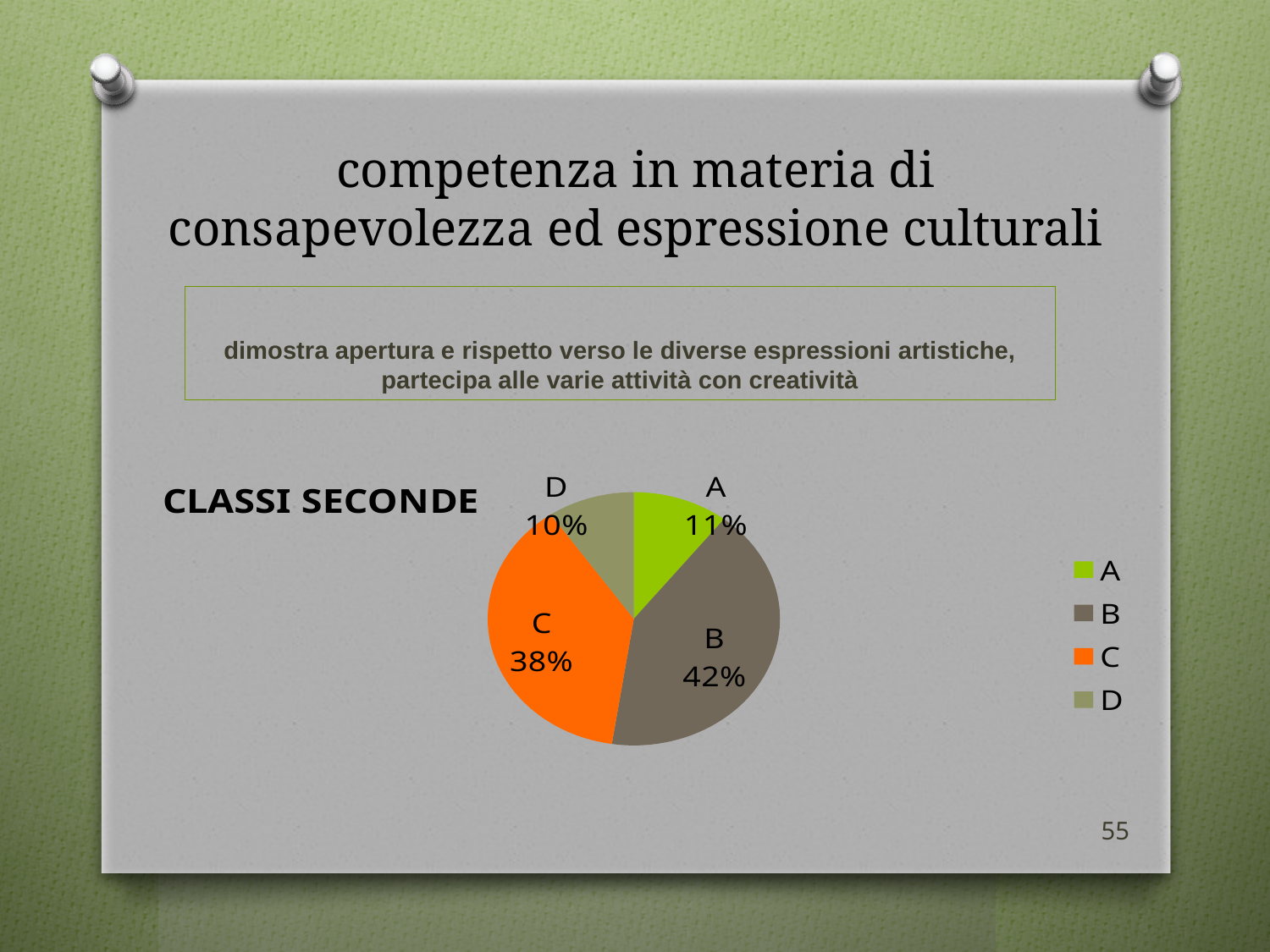
What is the difference in percentage points between category B and category C? 4 What percentage of the pie chart does category A represent? 11% What percentage of the pie chart does category C represent? 38% What type of chart is shown on the slide? pie chart How many categories are shown in the pie chart? 4 Which is larger, the share for A or the share for D? A What percentage of the pie chart does category B represent? 42% Which category has the largest share of the pie chart? B Which category has the smallest share of the pie chart? D What is the combined share of categories B and C? 80% What colour is used for category C in the pie chart? orange What percentage of the pie chart does category D represent? 10%